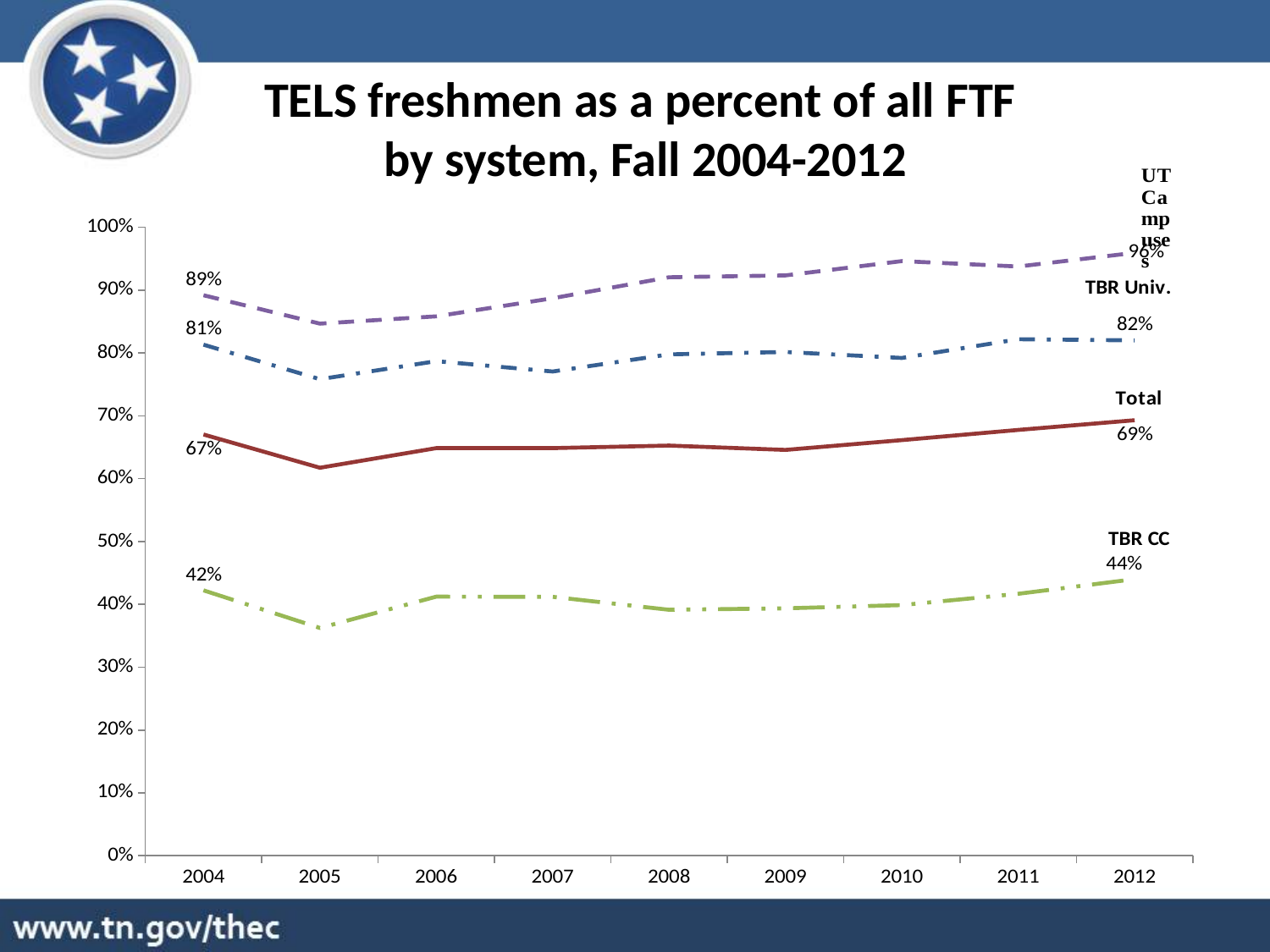
What was the TBR CC value in 2004? 42% What was the UT Campuses value in 2004? 89% By how many percentage points did the Total value change from 2004 to 2012? 2 percentage points What was the Total value in 2012? 69% Which system had the lowest value in 2012? TBR CC What was the TBR Univ. value in 2004? 81% Is the TBR CC value for 2005 greater or less than 40%? less How many years are shown on the x axis? 9 Which system had the highest value in 2004? UT Campuses How many series (systems) are plotted on the chart? 4 What kind of chart is shown on the slide? line chart Which is larger in 2012, the TBR Univ. value or the Total value? TBR Univ.